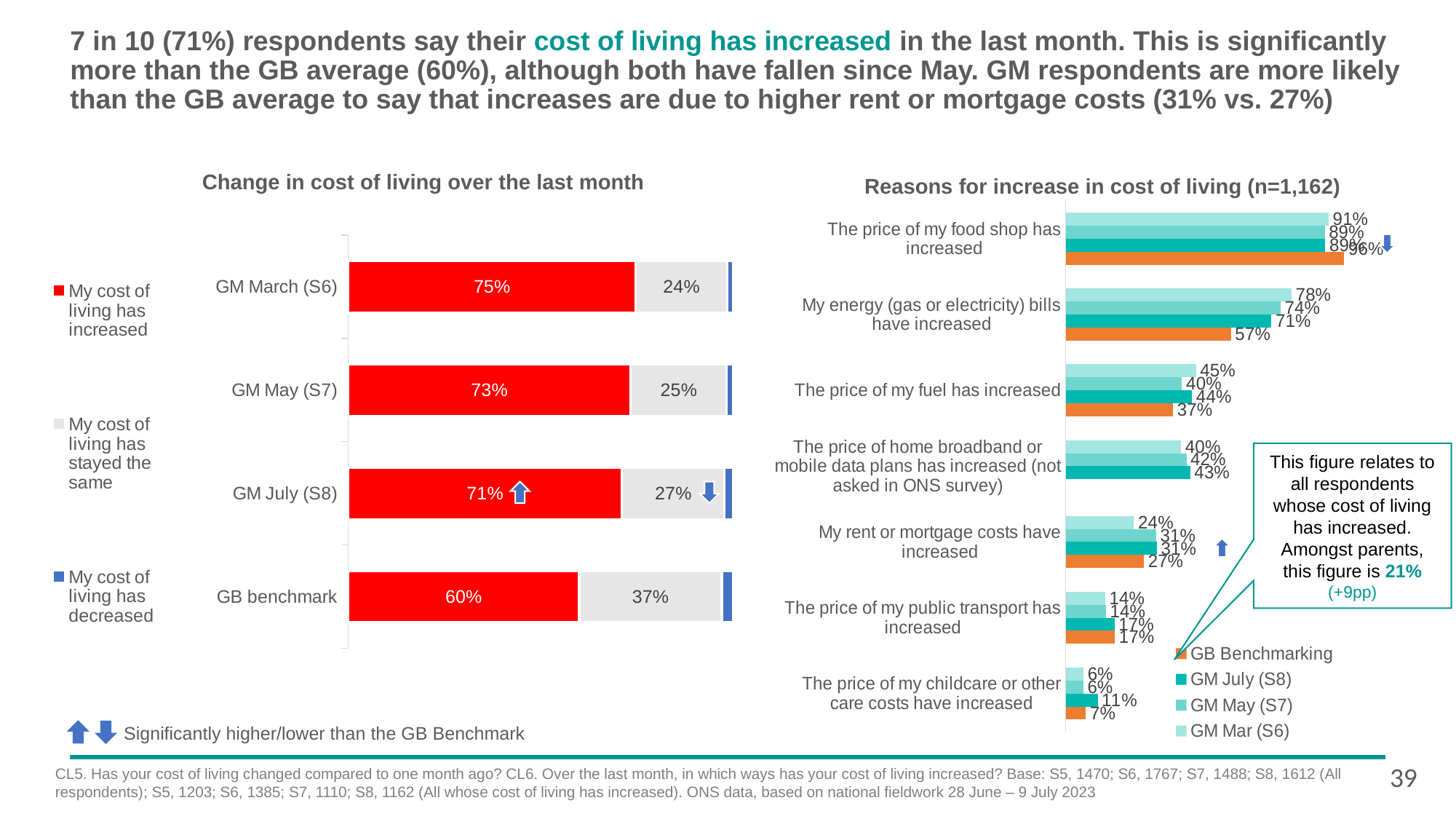
In the 'Reasons for increase in cost of living' chart, what is the GB Benchmarking value for 'The price of my fuel has increased'? 37% In the 'Change in cost of living over the last month' chart, what is the difference between the GM March (S6) and GB benchmark shares saying their cost of living has increased? 15 percentage points In the 'Change in cost of living over the last month' chart, what percentage of the GB benchmark say their cost of living has stayed the same? 37% In the 'Change in cost of living over the last month' chart, how many series does the legend list? 3 In the 'Reasons for increase in cost of living' chart, how many series does the legend list? 4 In the 'Change in cost of living over the last month' chart, what percentage of GM July (S8) respondents say their cost of living has increased? 71% In the 'Reasons for increase in cost of living' chart, what is the GM July (S8) value for 'My energy (gas or electricity) bills have increased'? 71% What kind of chart is 'Reasons for increase in cost of living (n=1,162)'? Bar chart In the 'Change in cost of living over the last month' chart, which category has the highest share saying their cost of living has increased? GM March (S6) In the 'Reasons for increase in cost of living' chart, how many reason categories are shown? 7 In the 'Change in cost of living over the last month' chart, does the share saying their cost of living has increased rise or fall from GM March (S6) to GM July (S8)? Fall In the 'Reasons for increase in cost of living' chart, which is larger for 'The price of my childcare or other care costs have increased': GM July (S8) or GB Benchmarking? GM July (S8)